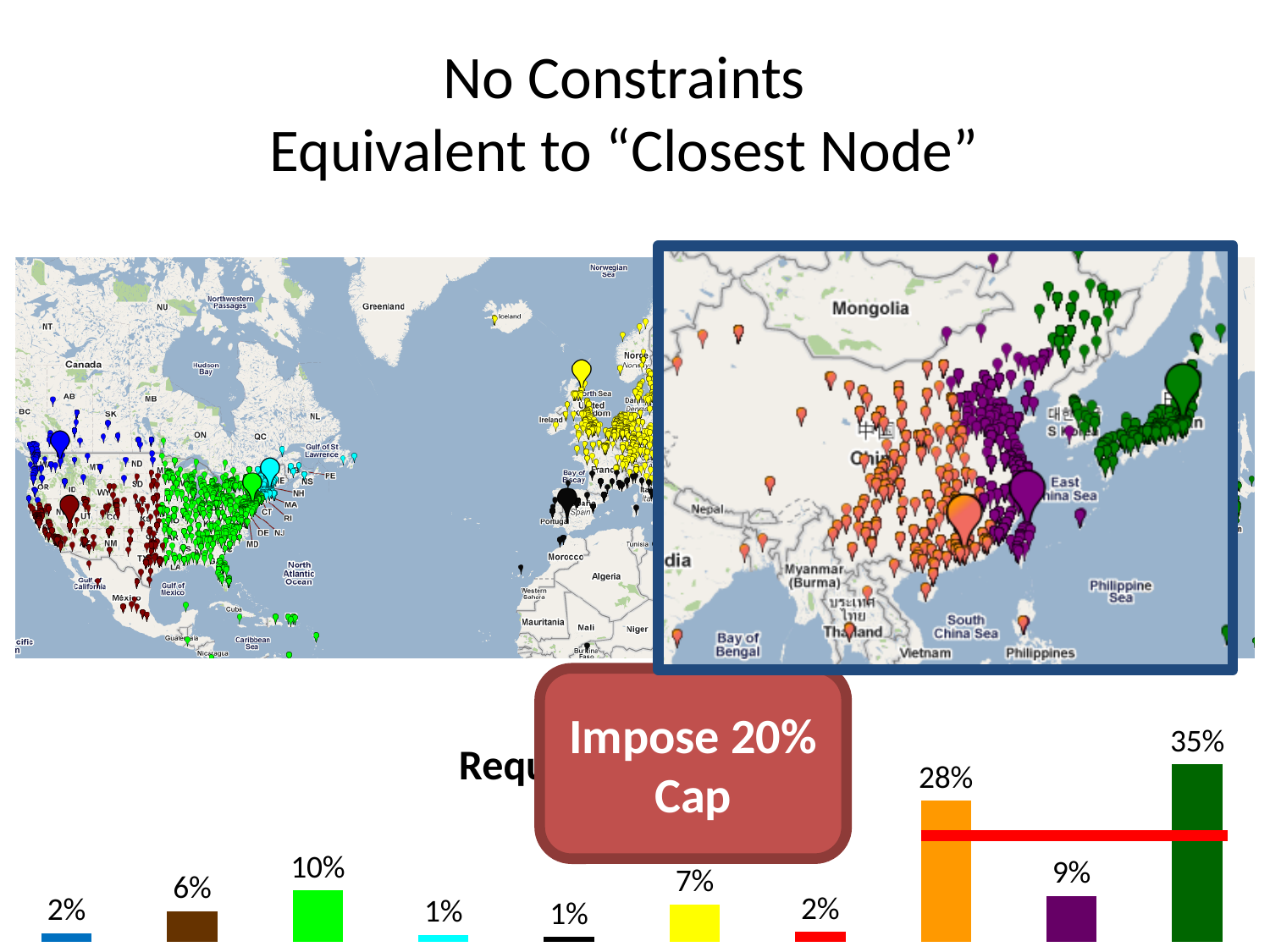
What is the value of the bright green bar in the bar chart? 10% How many bars are in the bar chart at the bottom of the slide? 10 Which bar has the highest value in the bar chart? the dark green bar (35%) What kind of chart is shown at the bottom of the slide? bar chart What is the difference between the dark green bar (35%) and the orange bar (28%)? 7% What is the value of the purple bar in the bar chart? 9% What is the value of the yellow bar in the bar chart? 7% What is the value of the orange bar in the bar chart? 28% What cap percentage does the red horizontal line across the bar chart represent, according to the callout box? 20% What is the lowest value shown in the bar chart? 1% What is the value of the dark green bar at the far right of the bar chart? 35% Which is larger in the bar chart, the orange bar or the purple bar? the orange bar